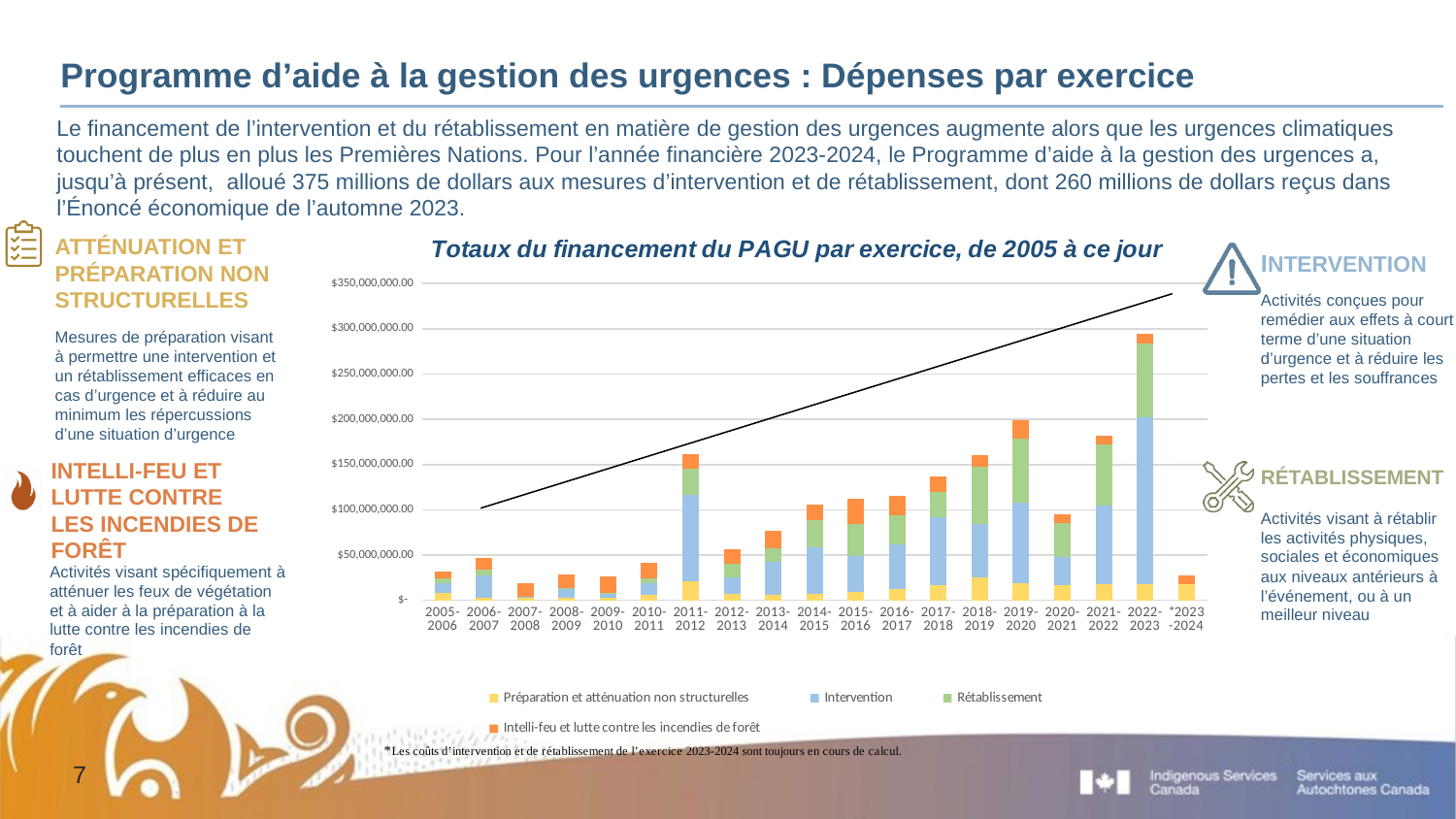
What is the title of the chart? Totaux du financement du PAGU par exercice, de 2005 à ce jour Is the total for 2013-2014 greater or less than $50,000,000.00? greater Overall, do the total funding amounts rise or fall from 2005-2006 to 2022-2023? rise Which fiscal year has a larger total, 2011-2012 or 2012-2013? 2011-2012 What kind of chart is shown on the slide? Stacked bar chart Which fiscal year has the highest total funding in the chart? 2022-2023 Which fiscal year has the lowest total funding in the chart? 2007-2008 Is the total for 2007-2008 greater or less than $50,000,000.00? less Is the total for 2022-2023 greater or less than $250,000,000.00? greater How many series does the chart's legend list? 4 How many fiscal years (bars) are shown on the x axis of the chart? 19